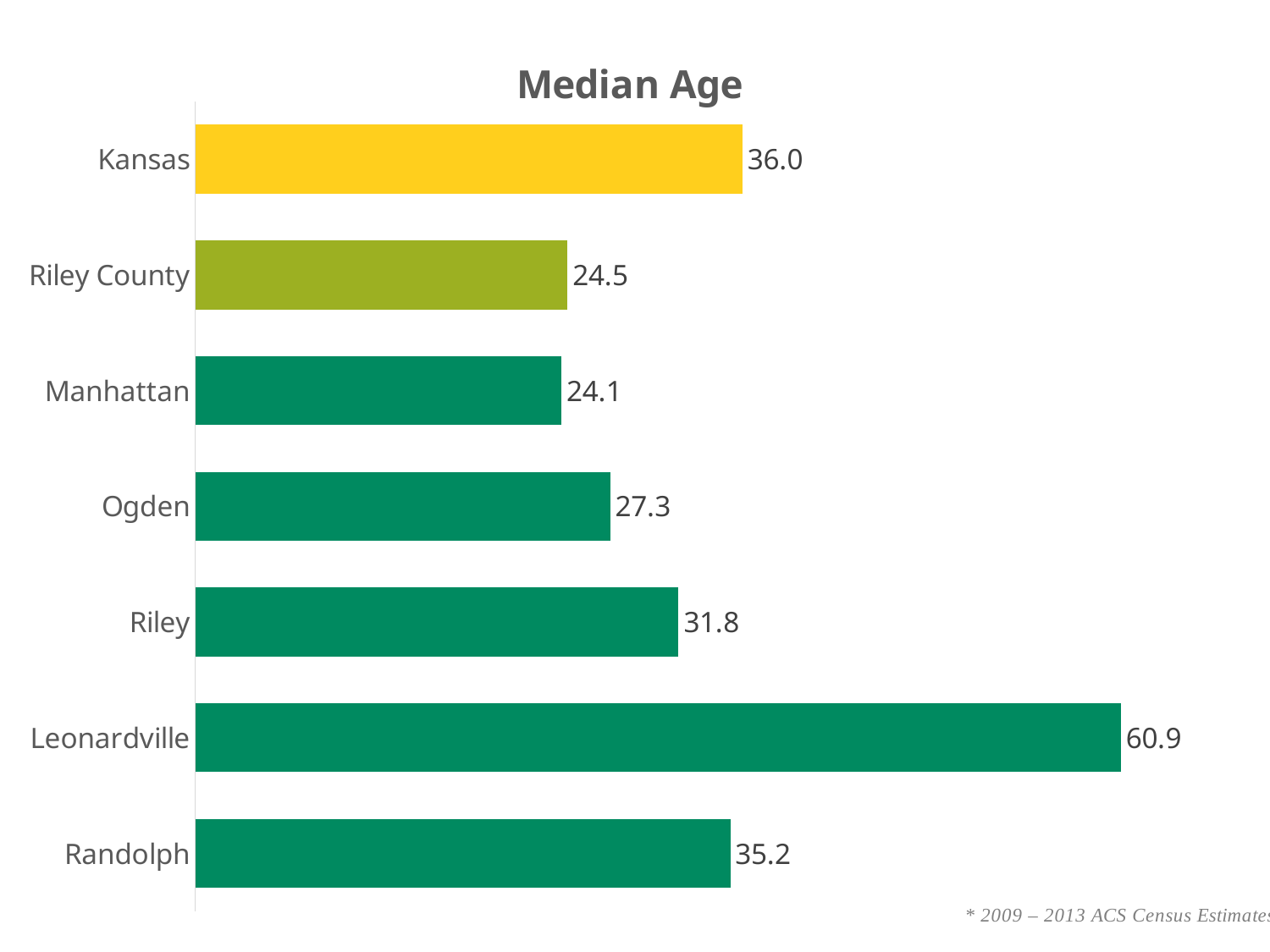
What is the median age shown for Kansas? 36.0 What is the title of the chart? Median Age How many categories are shown in the chart? 7 What is the median age shown for Ogden? 27.3 What is the difference between the median age of Kansas and Riley? 4.2 What is the median age shown for Riley County? 24.5 What is the median age shown for Leonardville? 60.9 Which category has the highest median age? Leonardville Which category has the lowest median age? Manhattan What is the difference between the median age of Leonardville and Randolph? 25.7 What kind of chart is shown on the slide? Bar chart Which has a higher median age, Riley or Ogden? Riley